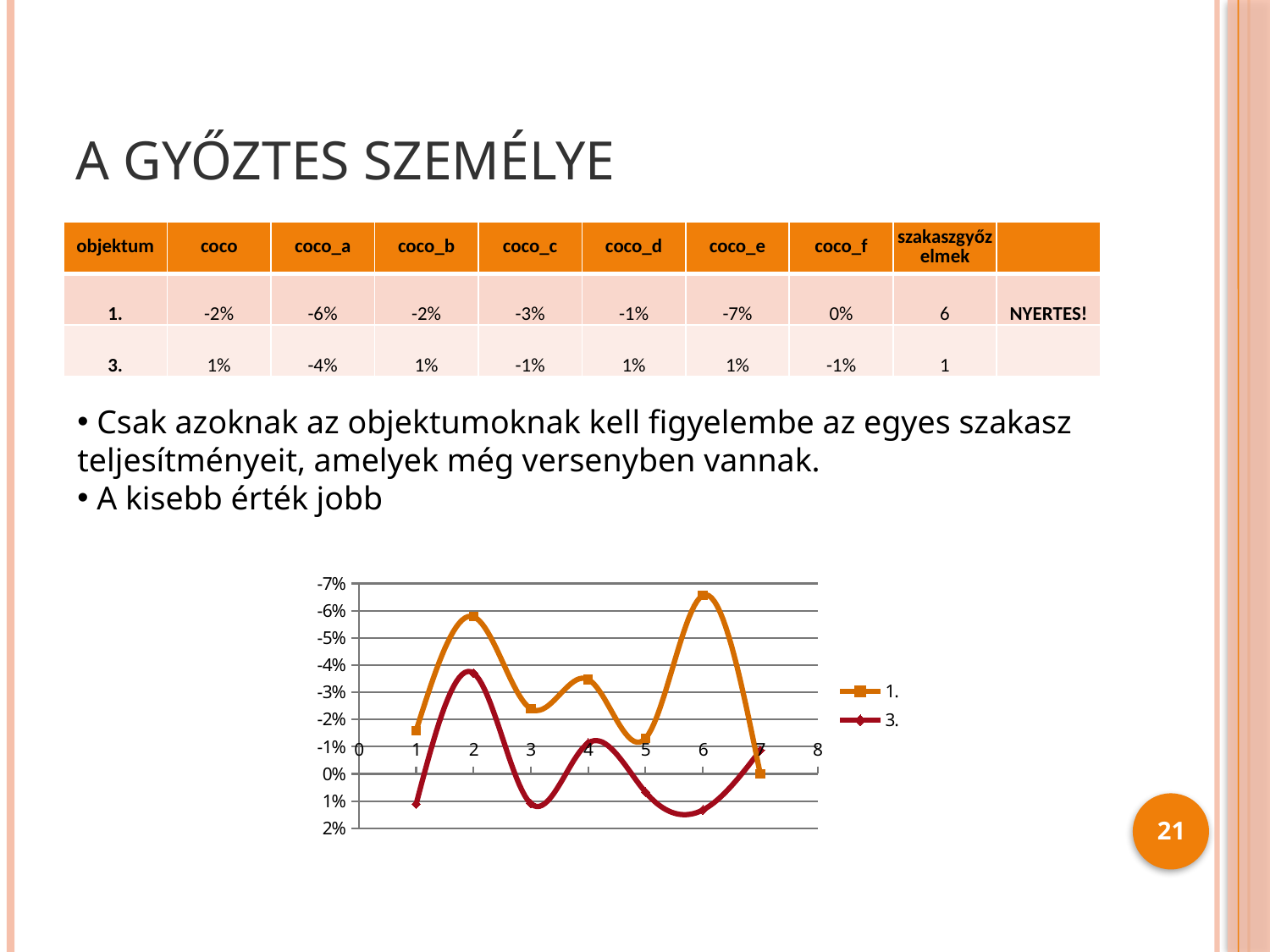
At which x value does series 1. reach its highest value? 7 How many series does the chart legend list? 2 How many data points does each series in the chart have? 7 At x = 2, which series has the lower value, 1. or 3.? 1. What kind of chart is shown on the slide? line chart What is the value of series 1. at x = 7 in the chart? 0% At which x value does series 1. reach its lowest (most negative) value? 6 What are the two series names shown in the chart legend? 1. and 3.